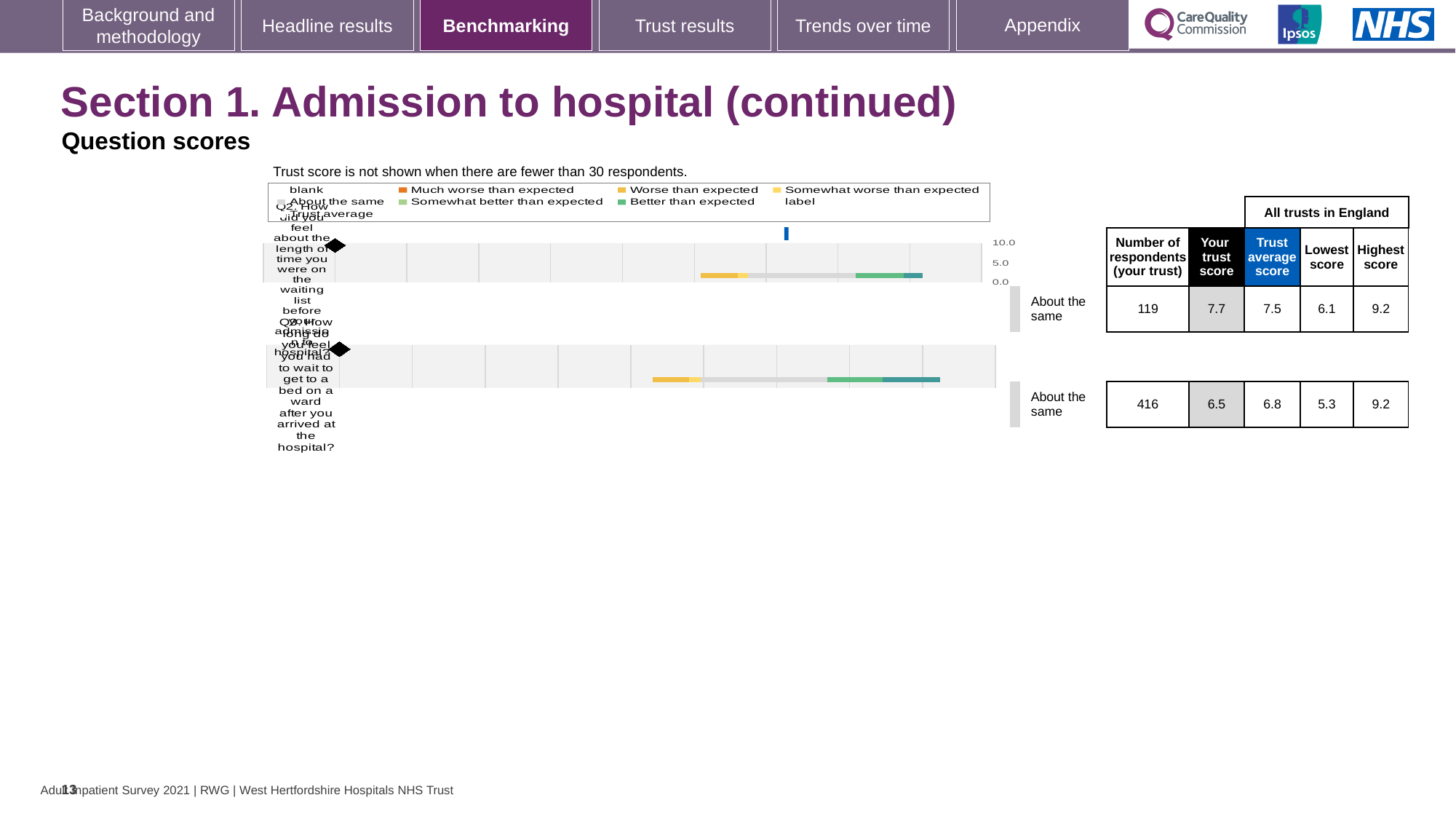
What is the difference between your trust score and the trust average score for Q2? 0.2 What is the trust average score for Q3? 6.8 How many questions are plotted in the question scores chart? 2 What is the trust score for Q3 (how long did you feel you had to wait to get to a bed on a ward)? 6.5 What is the highest score across all trusts in England for Q2? 9.2 How many respondents from the trust answered Q2? 119 What is the difference between the highest score and the lowest score for Q3? 3.9 Which question has more respondents from the trust, Q2 or Q3? Q3 What is the trust score for Q2 (how did you feel about the length of time on the waiting list)? 7.7 For Q2, which is larger: your trust score or the trust average score? Your trust score What benchmark category is shown next to the Q3 chart? About the same What kind of chart is used to show the question scores on this slide? Bar chart